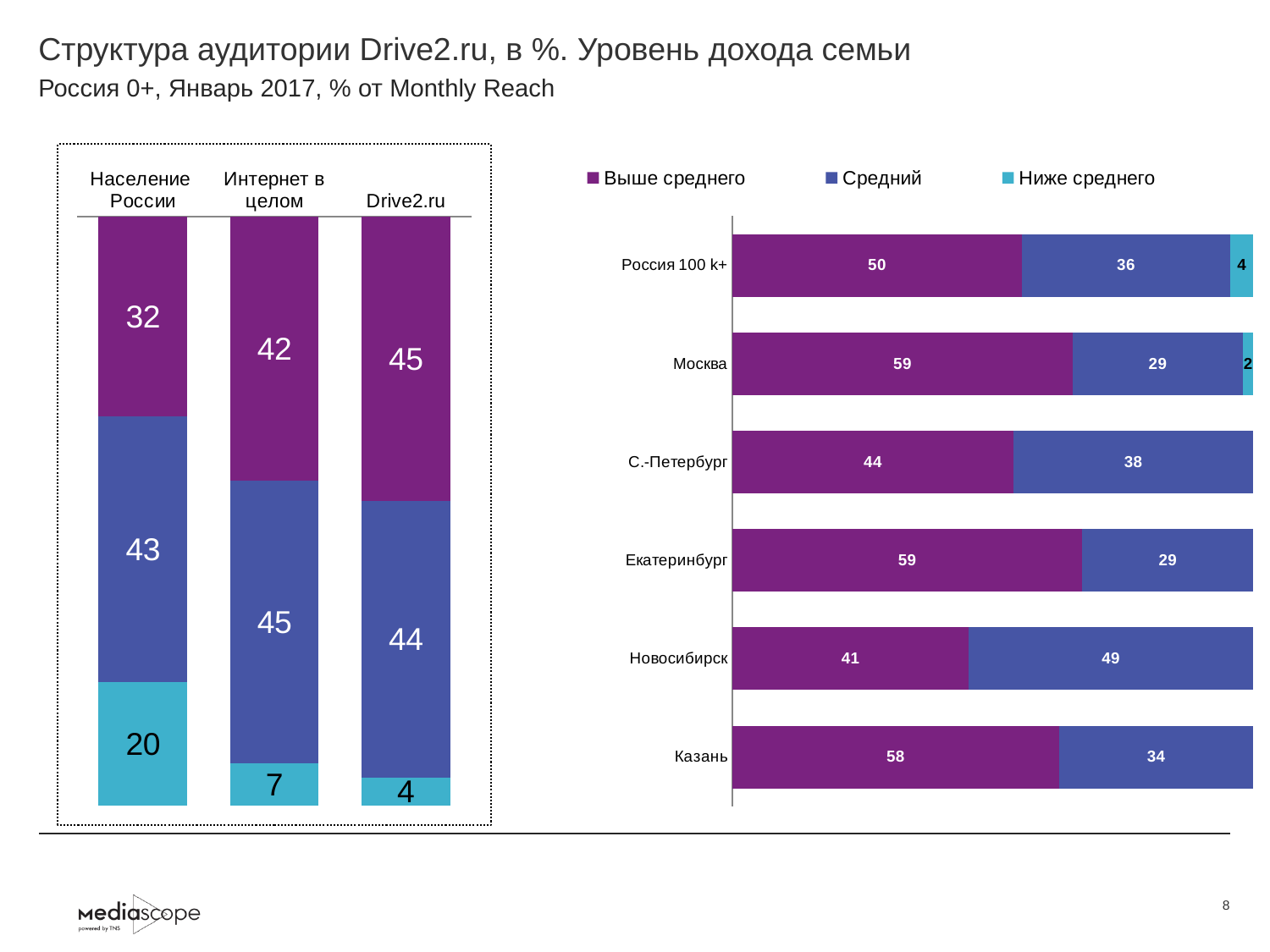
In the left chart, what is the difference between the 'Средний' values for 'Интернет в целом' and 'Drive2.ru'? 1 In the right chart, which city has the highest 'Средний' value? Новосибирск In the left chart, what is the total of the stacked bar for 'Население России'? 95 In the right chart, is the 'Выше среднего' value larger for 'Казань' or for 'С.-Петербург'? Казань How many series does the legend of the right chart list? 3 How many categories are shown in the right chart? 6 In the right chart, what is the 'Выше среднего' value for 'Москва'? 59 In the right chart, what is the 'Средний' value for 'Новосибирск'? 49 In the right chart, what is the total of the labeled segments for 'Россия 100 k+'? 90 In the left chart, what is the value of the top (Выше среднего) segment for 'Drive2.ru'? 45 In the left chart, what is the value of the 'Ниже среднего' segment for 'Население России'? 20 In the left chart, which category has the lowest 'Ниже среднего' value? Drive2.ru